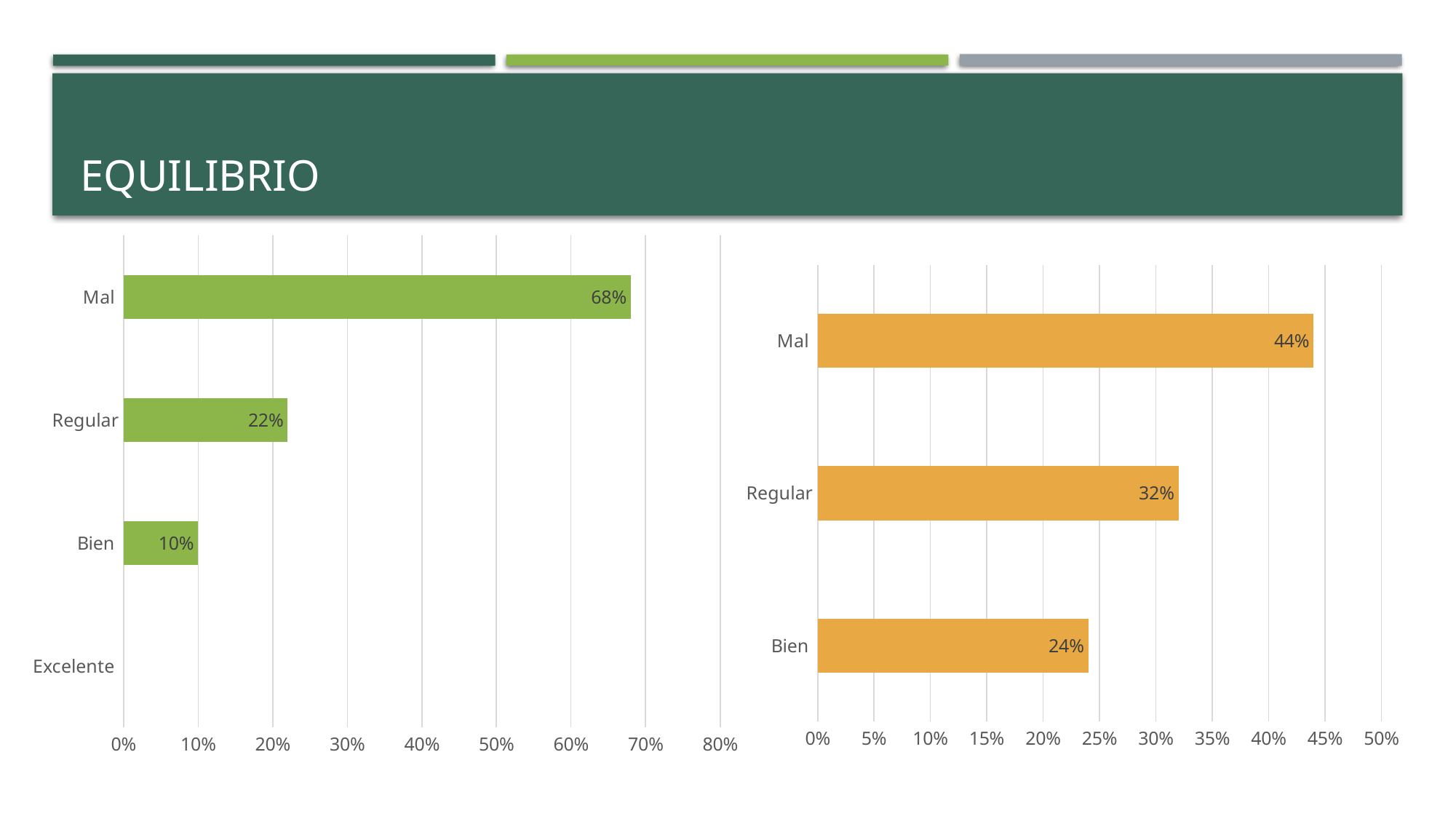
In the right chart, what is the value for Bien? 24% In the left chart, what is the value for Regular? 22% In the right chart, what is the difference between the values for Mal and Bien? 20% In the left chart, what is the value for Bien? 10% In the left chart, which category has the highest value? Mal In the right chart, what is the value for Regular? 32% How many categories are listed on the left chart's axis? 4 In the left chart, what is the value for Mal? 68% In the right chart, what is the value for Mal? 44% In the left chart, what is the difference between the values for Mal and Regular? 46% What type of chart is the right chart? Bar chart In the right chart, which category has the lowest value? Bien